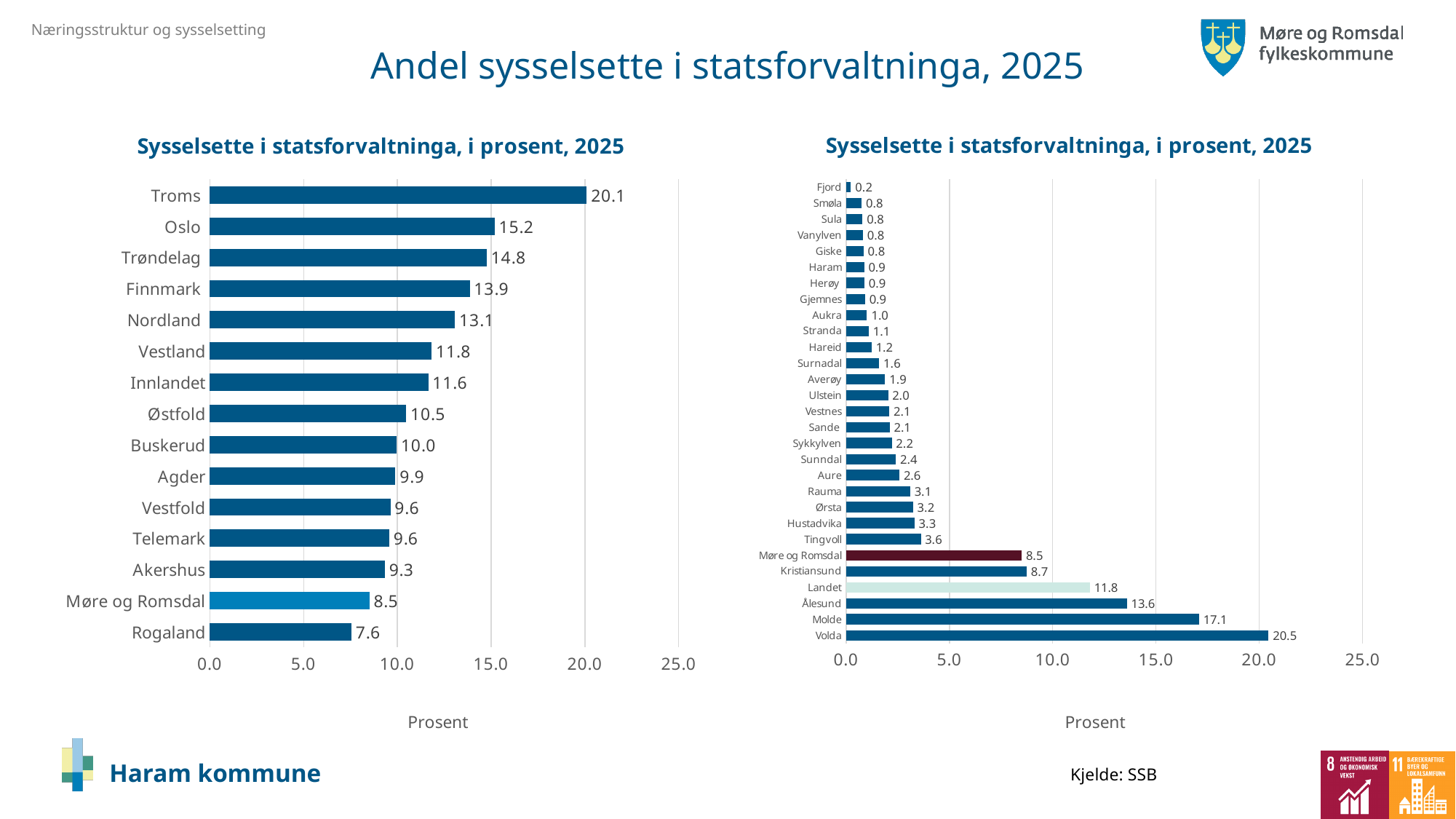
In the left chart, which category has the lowest value? Rogaland In the right chart, what is the value for Haram? 0.9 What type of chart is the left chart? Bar chart In the right chart, which category has the highest value? Volda In the left chart, what is the difference between Oslo and Trøndelag? 0.4 In the right chart, what is the difference between Molde and Ålesund? 3.5 How many categories are shown in the right chart? 29 In the right chart, what is the value for Landet? 11.8 How many categories are shown in the left chart? 15 In the left chart, what is the value for Møre og Romsdal? 8.5 In the left chart, what is the value for Troms? 20.1 In the left chart, which is larger, Vestland or Innlandet? Vestland